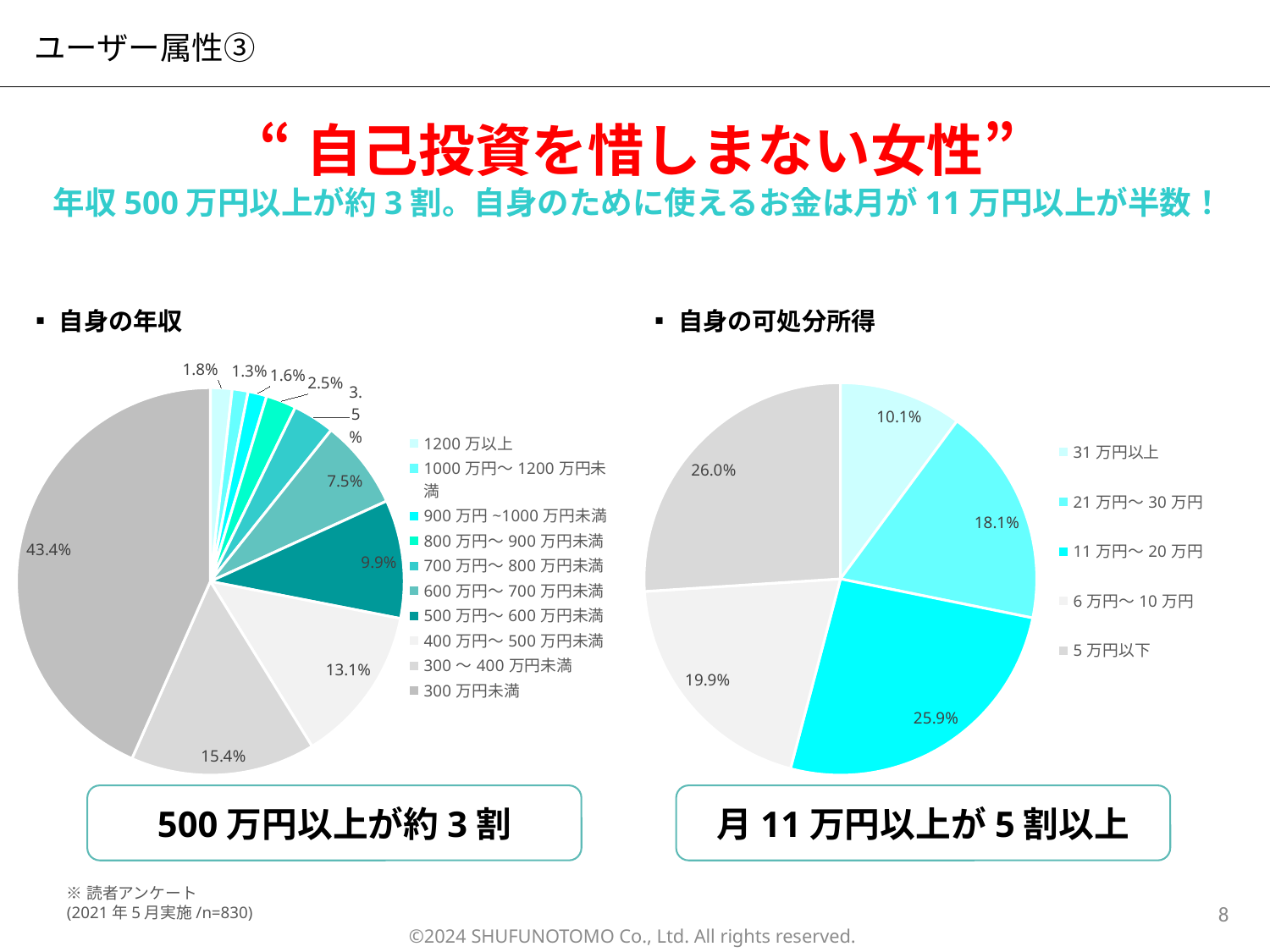
How many categories does the legend of the 自身の年収 chart list? 10 How many categories does the legend of the 自身の可処分所得 chart list? 5 In the 自身の年収 chart, which category has the smallest share? 1000万円～1200万円未満 In the 自身の年収 chart, which category has the largest share? 300万円未満 In the 自身の可処分所得 chart, which is larger: the share for 21万円～30万円 or the share for 6万円～10万円? 6万円～10万円 In the 自身の年収 chart, what percentage is shown for 300万円未満? 43.4% In the 自身の可処分所得 chart, what percentage is shown for 11万円～20万円? 25.9% In the 自身の可処分所得 chart, which category has the smallest share? 31万円以上 In the 自身の年収 chart, what percentage is shown for 500万円～600万円未満? 9.9% What type of chart is the 自身の可処分所得 chart? Pie chart In the 自身の可処分所得 chart, what percentage is shown for 31万円以上? 10.1% In the 自身の年収 chart, what is the difference between the shares for 300～400万円未満 and 400万円～500万円未満? 2.3%